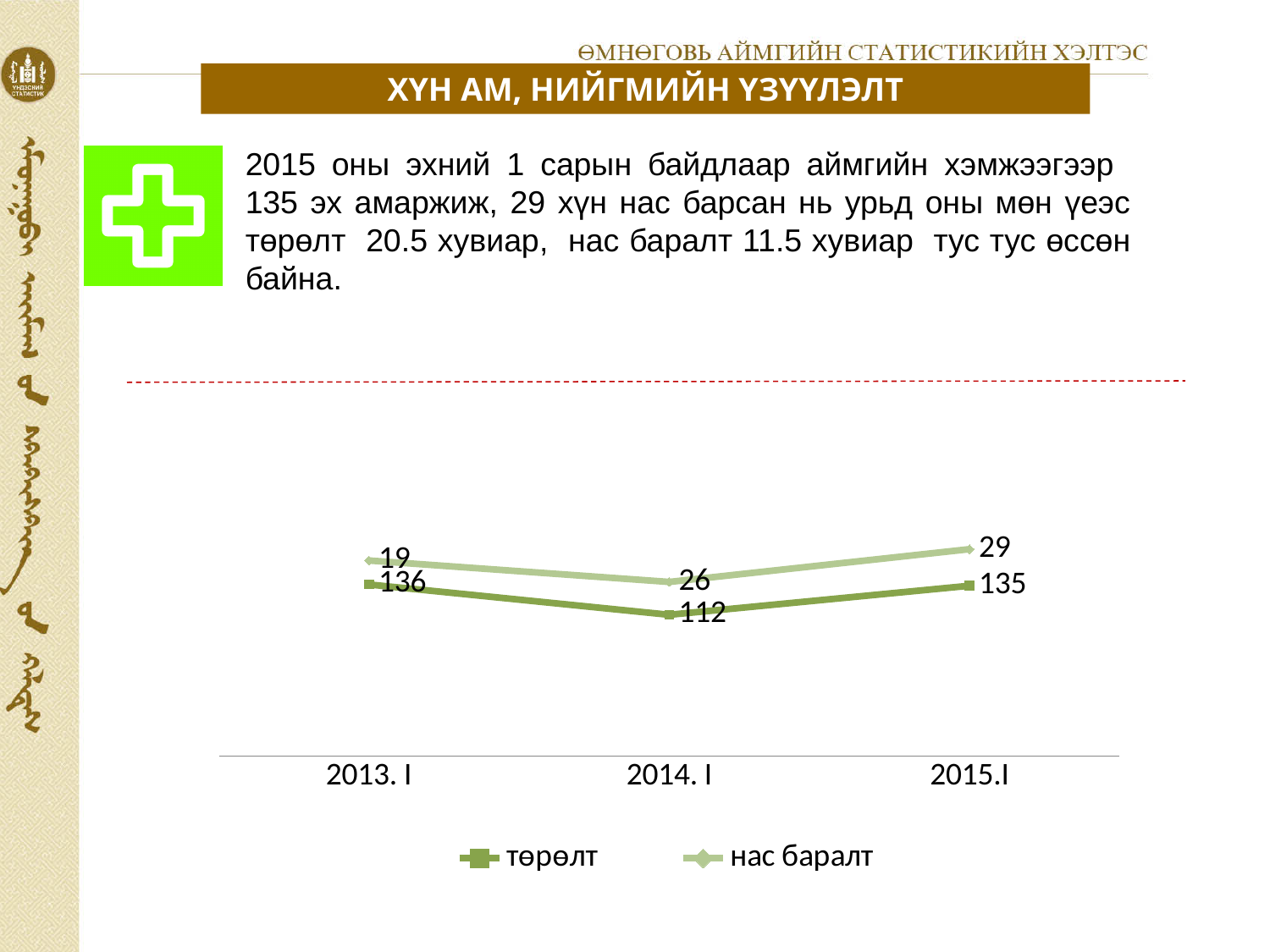
In which period is нас баралт highest? 2015.I What is the value of төрөлт for 2014. I? 112 How many series does the legend list? 2 In which period is төрөлт lowest? 2014. I What is the value of нас баралт for 2014. I? 26 Which series is shown with the lighter green line in the legend? нас баралт What is the value of нас баралт for 2015.I? 29 What is the value of төрөлт for 2013. I? 136 Does нас баралт rise or fall from 2013. I to 2015.I? rise What type of chart is shown on the slide? line chart How many points are plotted along the x axis for each series? 3 What is the difference between төрөлт in 2013. I and 2014. I? 24